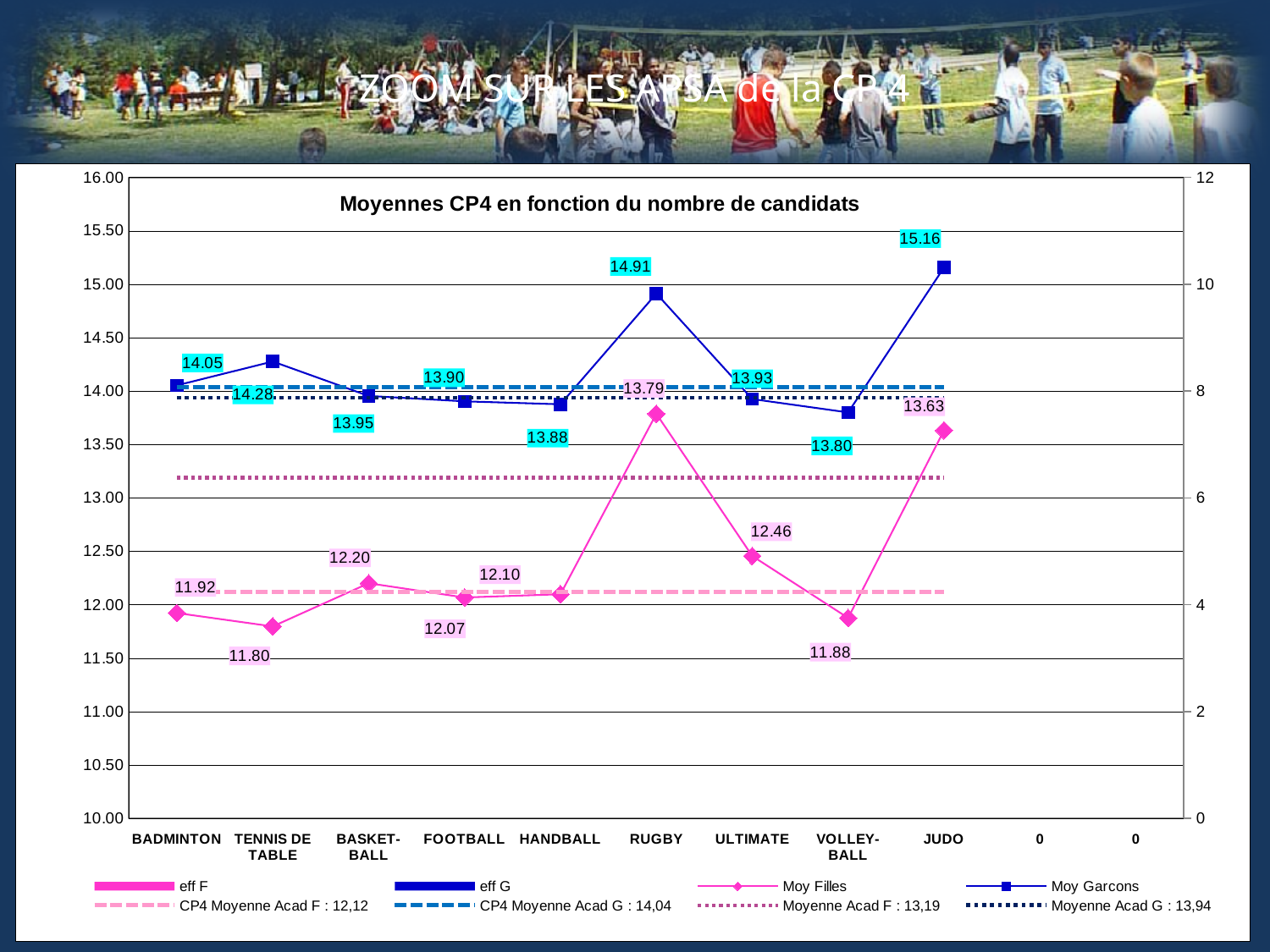
Which category has the highest Moy Garcons value? JUDO How many series does the legend list? 8 What is the title of the chart? Moyennes CP4 en fonction du nombre de candidats What is the Moy Garcons value for TENNIS DE TABLE? 14.28 What is the Moy Garcons value for JUDO? 15.16 Which is larger for RUGBY: the Moy Garcons value or the Moy Filles value? Moy Garcons What kind of chart is this? Line chart What is the Moy Filles value for RUGBY? 13.79 What is the difference between the Moy Garcons and Moy Filles values for JUDO? 1.53 What is the Moy Filles value for ULTIMATE? 12.46 Which category has the lowest Moy Filles value? TENNIS DE TABLE Which category has the highest Moy Filles value? RUGBY